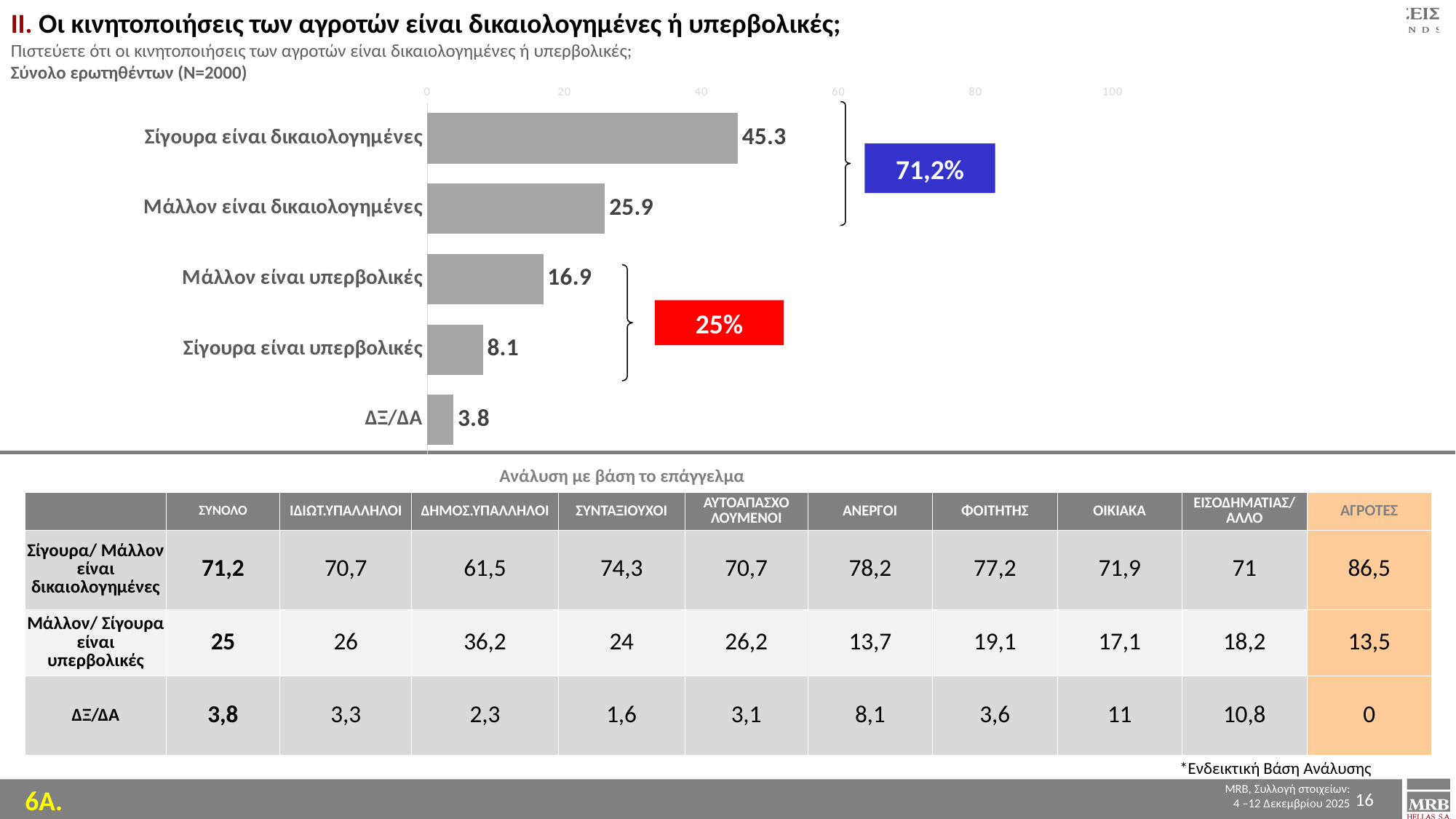
What is the value for "Σίγουρα είναι δικαιολογημένες" in the bar chart? 45.3 What is the value for "ΔΞ/ΔΑ" in the bar chart? 3.8 What kind of chart is shown on the slide? Bar chart Which category has the highest value in the bar chart? Σίγουρα είναι δικαιολογημένες What percentage is shown in the blue box next to the bar chart? 71,2% Which category has the lowest value in the bar chart? ΔΞ/ΔΑ What is the value for "Σίγουρα είναι υπερβολικές" in the bar chart? 8.1 What is the value for "Μάλλον είναι δικαιολογημένες" in the bar chart? 25.9 What is the value for "Μάλλον είναι υπερβολικές" in the bar chart? 16.9 Which is larger in the bar chart: "Μάλλον είναι υπερβολικές" or "Σίγουρα είναι υπερβολικές"? Μάλλον είναι υπερβολικές How many categories are shown in the bar chart? 5 What is the difference between the values for "Σίγουρα είναι δικαιολογημένες" and "Μάλλον είναι δικαιολογημένες" in the bar chart? 19.4